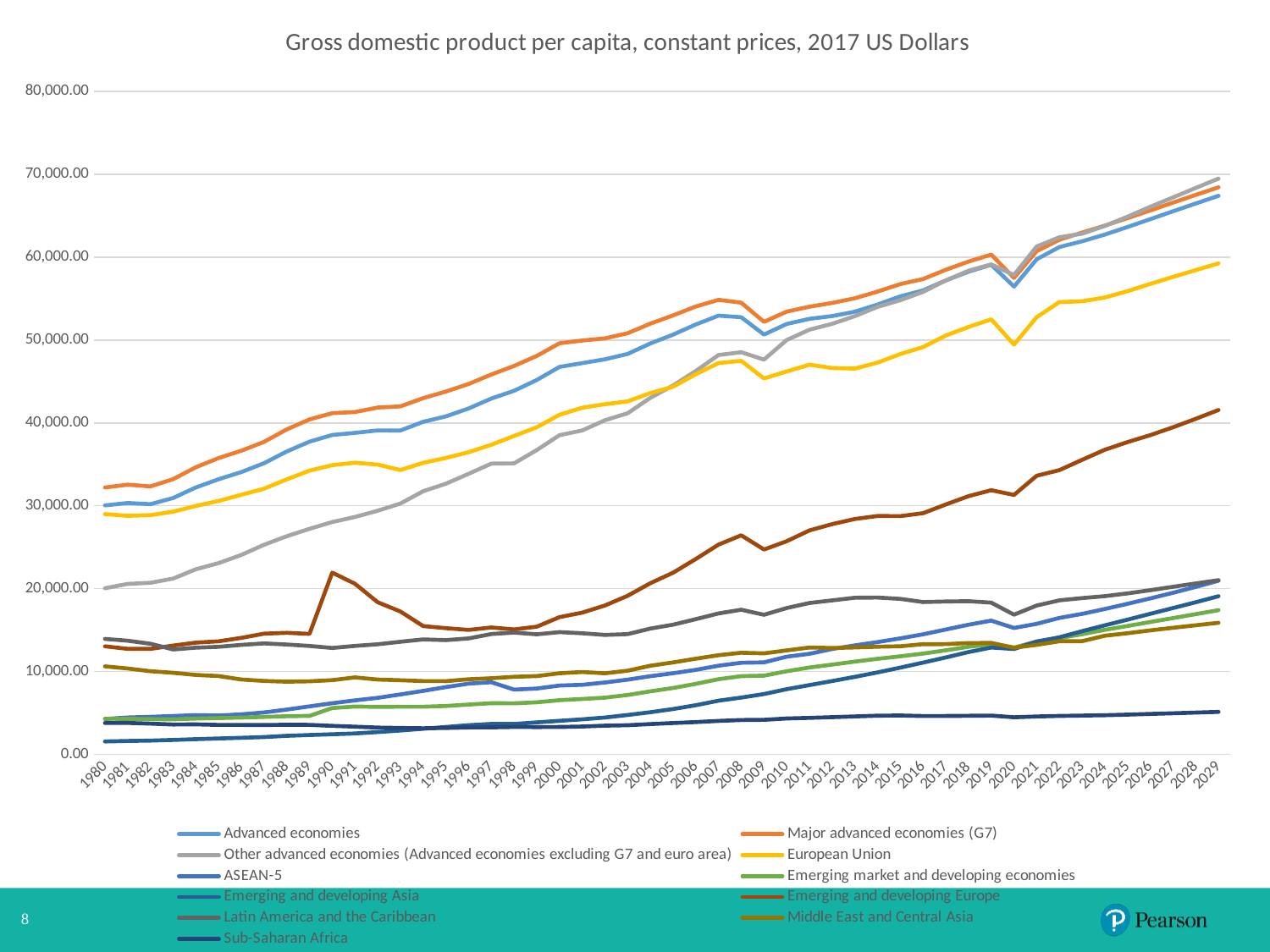
Which series has the lowest value in 1980? Emerging and developing Asia What is the title of the chart? Gross domestic product per capita, constant prices, 2017 US Dollars Which series has the lowest value in 2029? Sub-Saharan Africa How many years are plotted along the x axis? 50 What kind of chart is shown on the slide? Line chart In 2029, which is larger: Major advanced economies (G7) or European Union? Major advanced economies (G7) How many series does the legend list? 11 Is the value for European Union in 2029 greater or less than 60,000.00? less Does the Advanced economies series generally rise or fall from 1980 to 2029? Rise Is the value for Major advanced economies (G7) in 1980 greater or less than 30,000.00? greater Is the value for Emerging and developing Asia in 1980 greater or less than 10,000.00? less